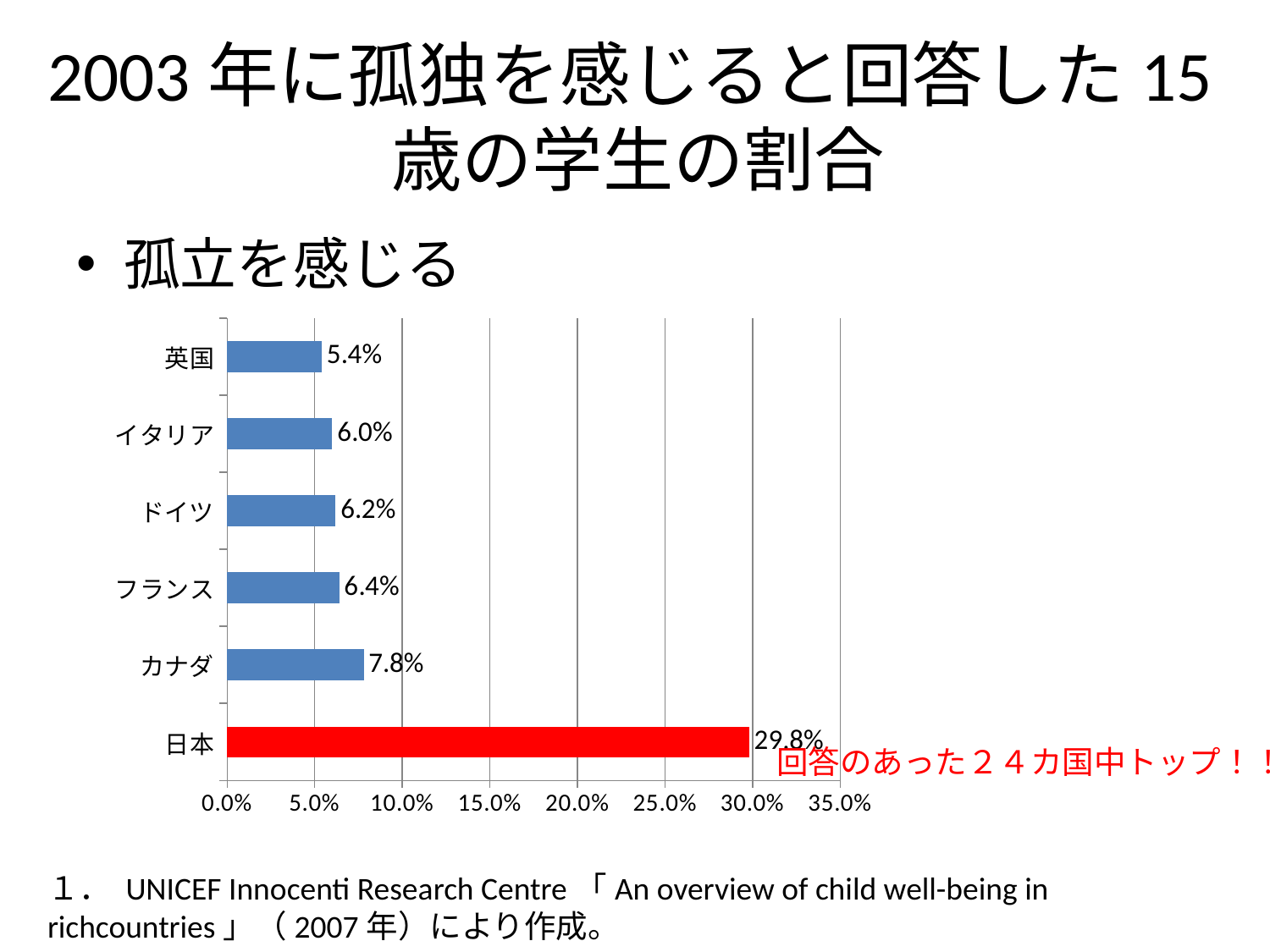
What kind of chart is shown on the slide? bar chart Is the value for 日本 greater or less than 25.0%? greater What is the difference between the values for 日本 and カナダ? 22.0% How many countries are shown in the chart? 6 What is the value for 日本 (Japan)? 29.8% What is the difference between the values for フランス and イタリア? 0.4% What is the value for 英国 (UK)? 5.4% What is the value for カナダ (Canada)? 7.8% What is the value for ドイツ (Germany)? 6.2% Which country has the highest value? 日本 Which country has the lowest value? 英国 Which is larger, the value for カナダ or the value for フランス? カナダ